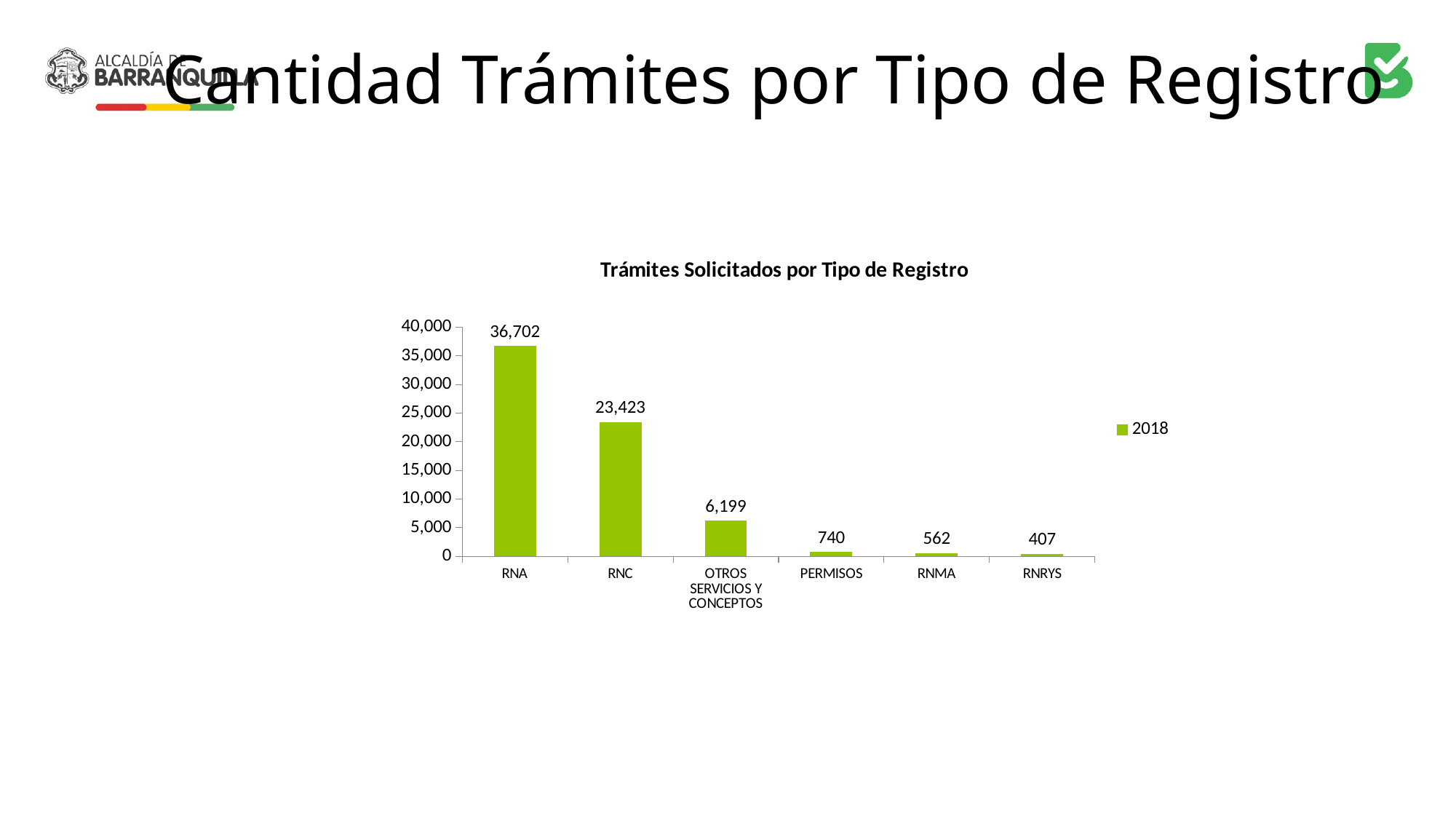
Which category has the highest value? RNA What is the value for RNC? 23,423 What is the value for OTROS SERVICIOS Y CONCEPTOS? 6,199 Which category has the lowest value? RNRYS How many series does the legend list? 1 Which is larger, the value for RNMA or the value for RNRYS? RNMA What is the value for PERMISOS? 740 What is the difference between the values for RNA and RNC? 13,279 What kind of chart is shown? bar chart What is the value for RNA? 36,702 How many categories are shown on the x axis? 6 Is the value for RNC greater or less than 20,000? greater